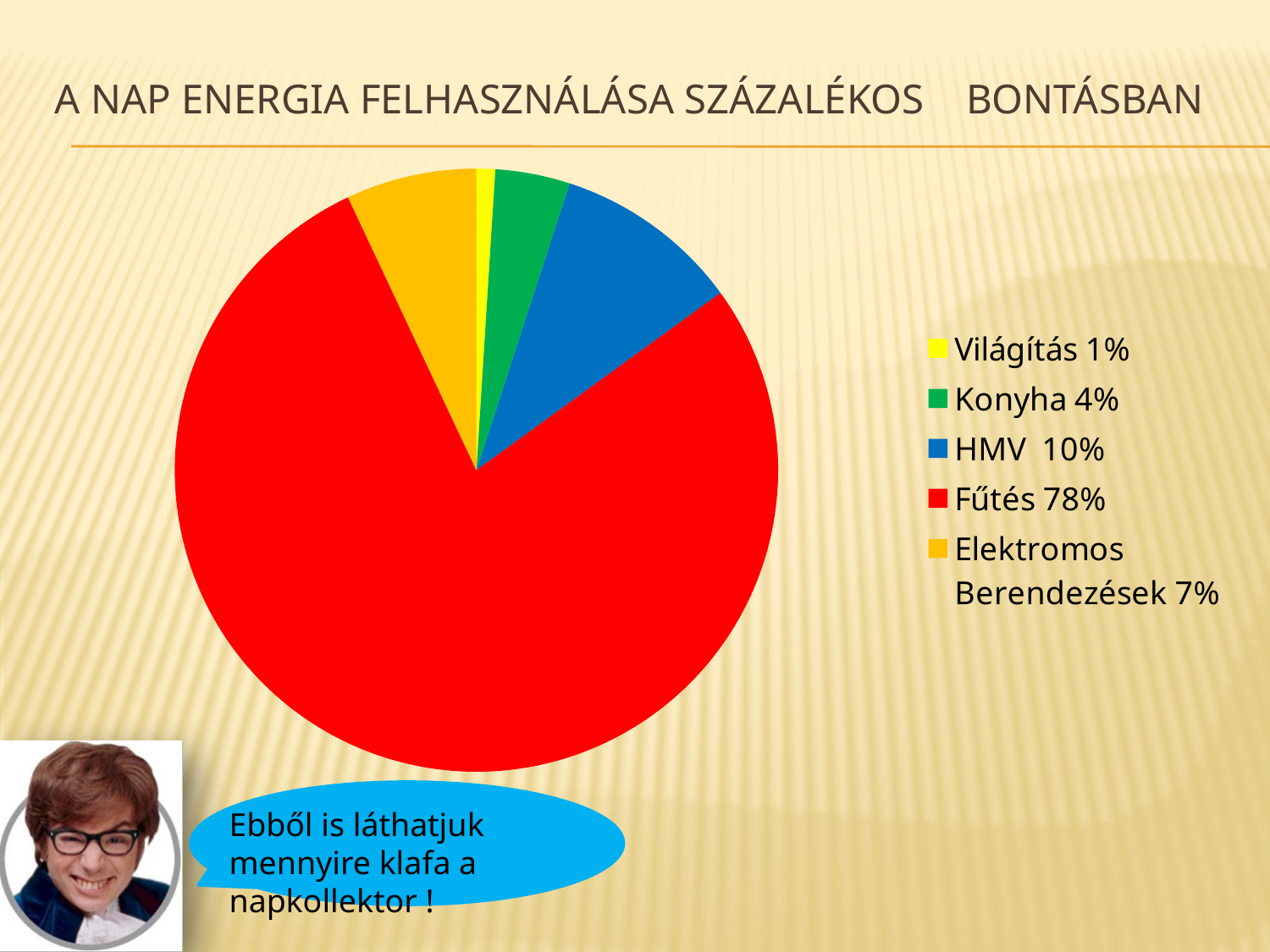
Which is larger, the share for Konyha or the share for Elektromos Berendezések? Elektromos Berendezések What percentage does the legend give for HMV? 10% What percentage does the legend give for Elektromos Berendezések? 7% What kind of chart is shown on the slide? pie chart How many categories does the pie chart have? 5 Which category has the smallest share of the pie? Világítás What percentage does the legend give for Fűtés? 78% What is the title of the chart slide? A nap energia felhasználása százalékos bontásban What is the difference in percentage points between Fűtés and HMV? 68 Which category has the largest share of the pie? Fűtés What percentage does the legend give for Konyha? 4% What colour is the slice for Fűtés? red